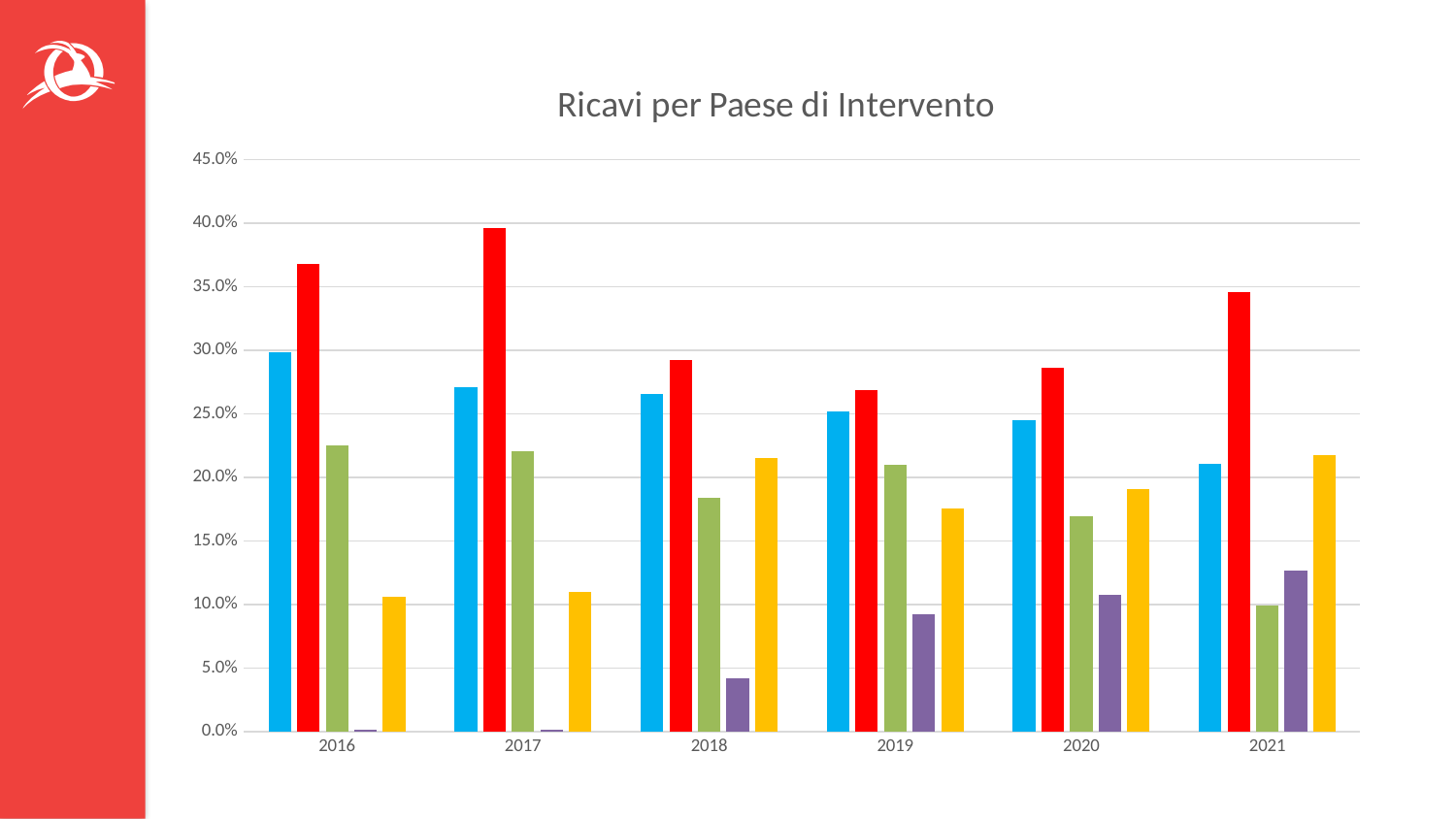
Is the value of the purple bar for 2018 greater or less than 5.0%? less Do the blue bars rise or fall from 2016 to 2021? fall Is the value of the blue bar for 2021 greater or less than 25.0%? less In which year is the blue bar the lowest? 2021 How many differently coloured bars are shown for 2018? 5 Is the value of the yellow bar for 2016 greater or less than 15.0%? less In 2017, which coloured bar is the highest? red In which year is the red bar the highest? 2017 What kind of chart is shown on the slide? bar chart How many years are shown on the x axis of the chart? 6 What is the title of the chart? Ricavi per Paese di Intervento